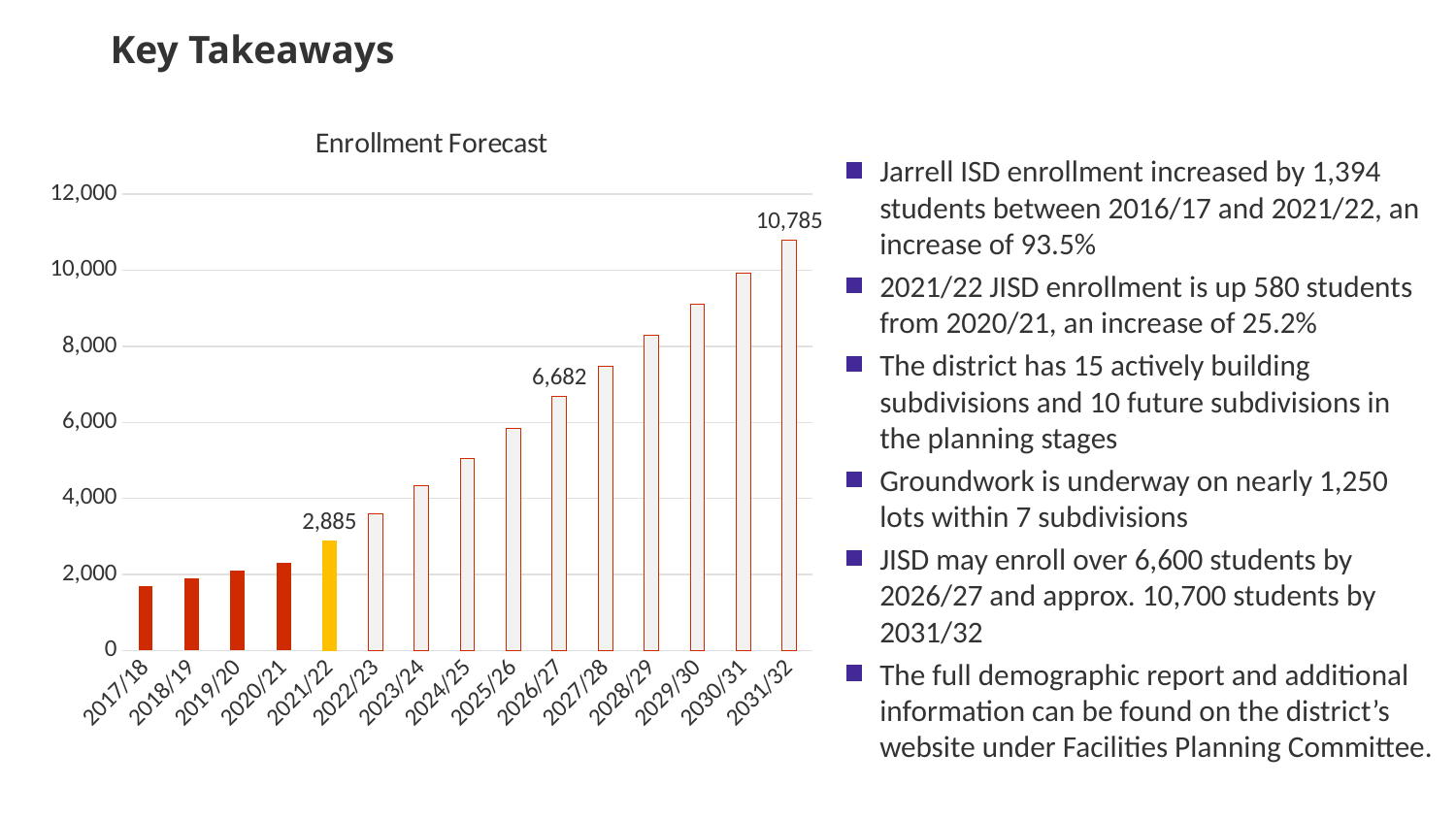
Which year has the lowest enrollment value in the chart? 2017/18 What is the difference between the enrollment values for 2031/32 and 2026/27? 4,103 Do the enrollment values rise or fall from 2017/18 to 2031/32? rise What is the enrollment value shown for 2031/32? 10,785 Which year has the highest enrollment value in the chart? 2031/32 What type of chart is shown on the slide? bar chart What is the difference between the enrollment values for 2026/27 and 2021/22? 3,797 What is the title of the chart? Enrollment Forecast What is the enrollment value shown for 2021/22? 2,885 What is the enrollment value shown for 2026/27? 6,682 How many years (categories) are shown on the x axis of the chart? 15 Is the value for 2029/30 greater or less than 8,000? greater